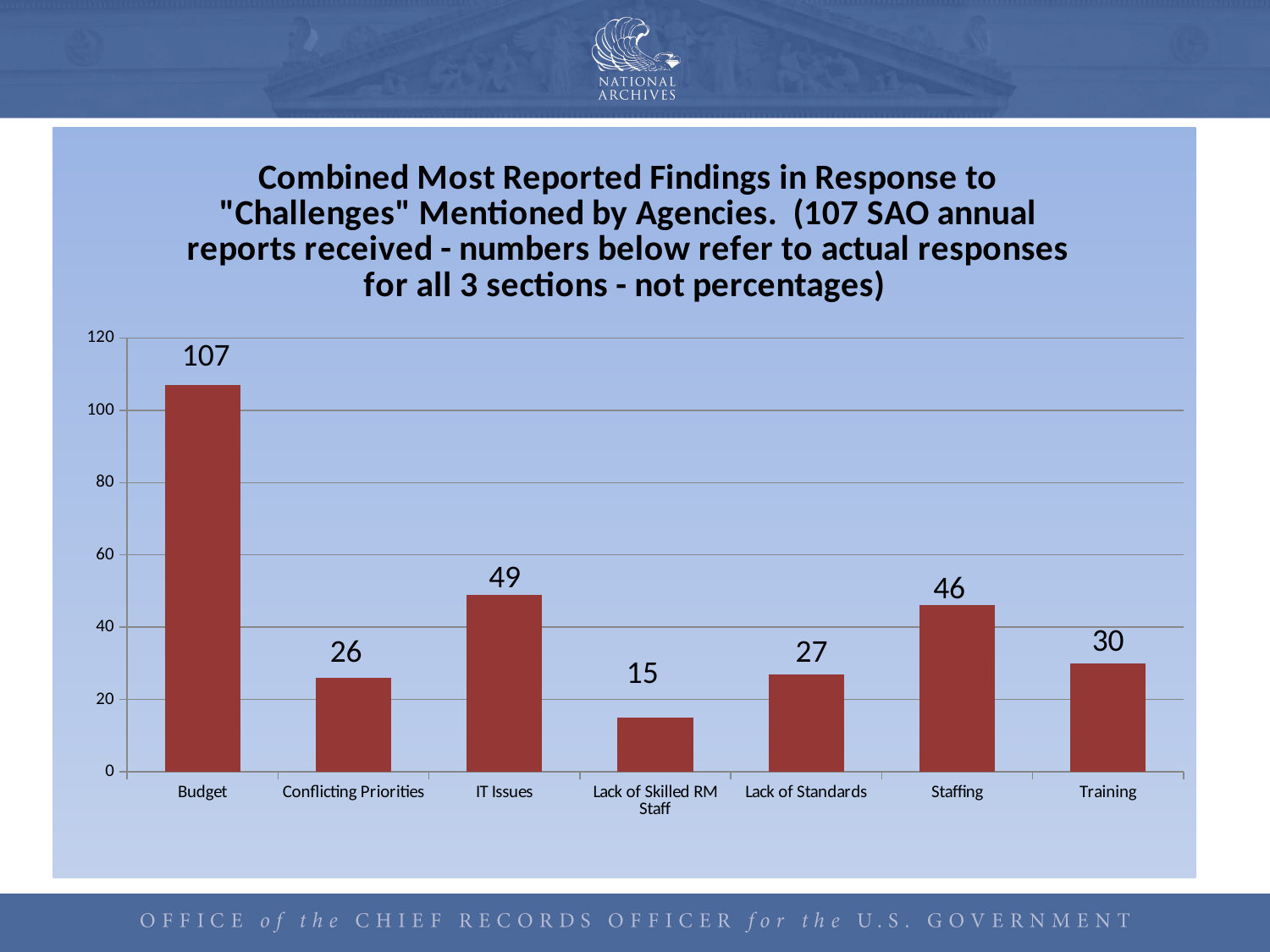
What is the difference between the values for IT Issues and Conflicting Priorities? 23 Is the value for Lack of Standards greater or less than 40? less What is the difference between the values for Budget and Staffing? 61 What is the value for IT Issues? 49 What is the value for Lack of Skilled RM Staff? 15 What kind of chart is shown on the slide? bar chart How many categories are shown on the x axis? 7 Which category has the lowest value? Lack of Skilled RM Staff Which is larger, the value for Staffing or the value for Training? Staffing What is the value for Training? 30 Which category has the highest value? Budget What is the value for Budget? 107